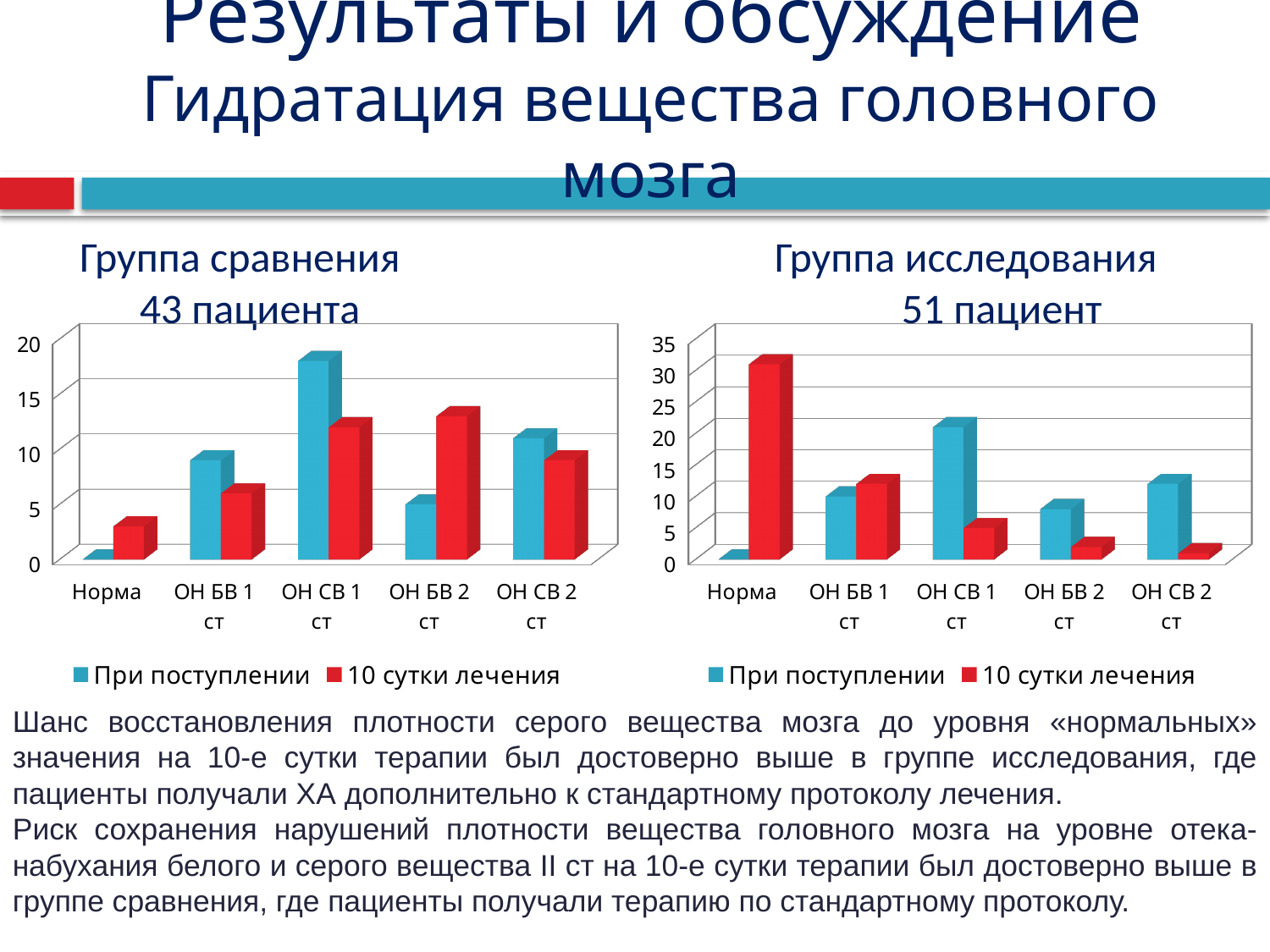
How many categories are shown on the x axis of the "Группа исследования 51 пациент" chart on the right? 5 How many series does the legend of the left chart "Группа сравнения 43 пациента" list? 2 In the left chart "Группа сравнения 43 пациента", which category has the lowest value for the "При поступлении" series? Норма In the right chart "Группа исследования 51 пациент", for ОН СВ 2 ст, which series has the larger value: "При поступлении" or "10 сутки лечения"? При поступлении In the left chart "Группа сравнения 43 пациента", for ОН БВ 2 ст, which series has the larger value: "При поступлении" or "10 сутки лечения"? 10 сутки лечения What kind of chart is the "Группа сравнения 43 пациента" chart on the left? bar chart In the right chart "Группа исследования 51 пациент", which category has the highest value for the "10 сутки лечения" series? Норма In the left chart "Группа сравнения 43 пациента", which category has the highest value for the "При поступлении" series? ОН СВ 1 ст What is the title of the chart on the right? Группа исследования 51 пациент In the left chart "Группа сравнения 43 пациента", is the "При поступлении" value for ОН СВ 1 ст greater or less than 15? greater